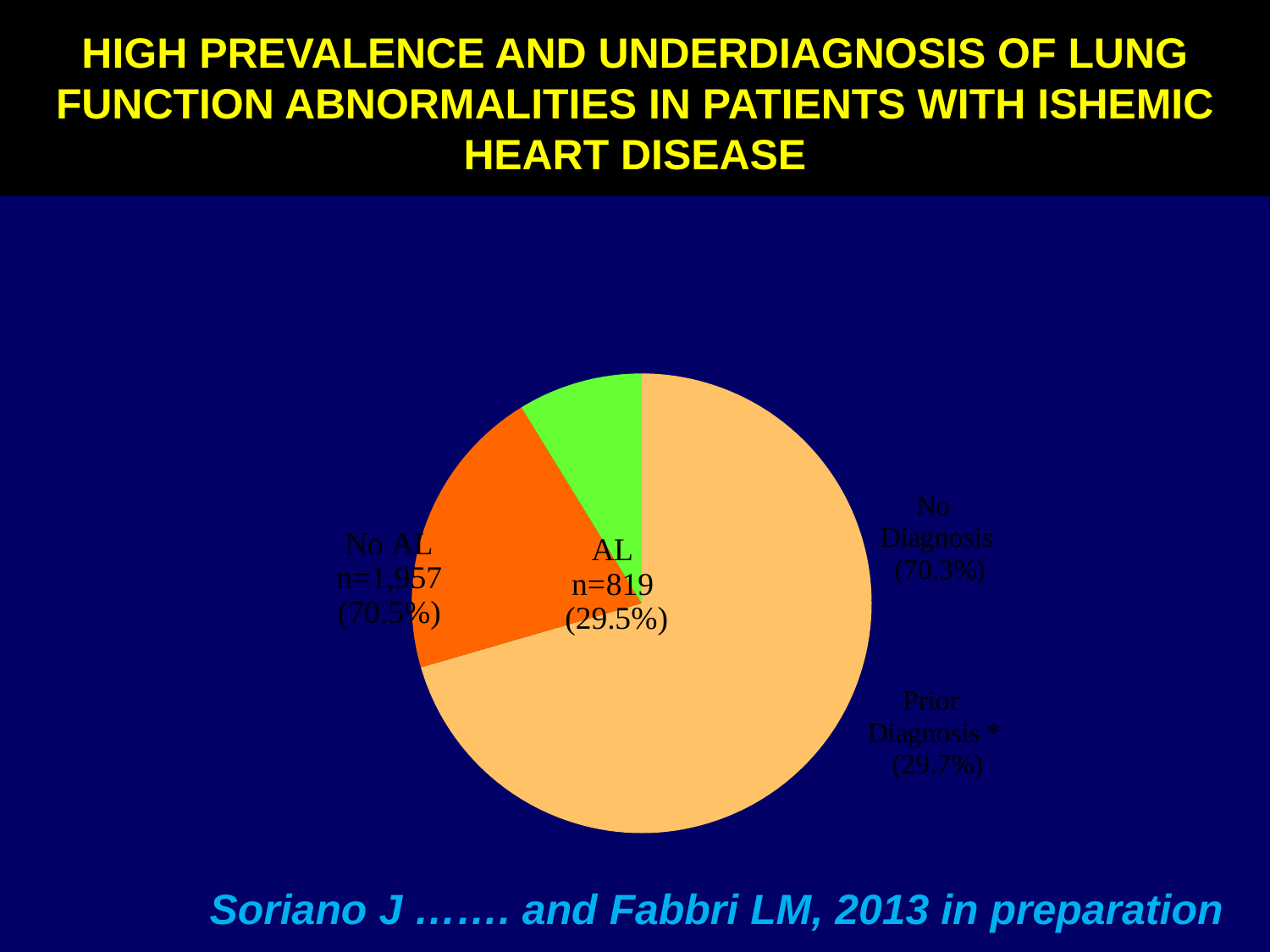
What is the combined number of patients in the No AL and AL groups? 2,776 What kind of chart is shown on the slide? pie chart What percentage is shown for Prior Diagnosis *? 29.7% What percentage is shown for No Diagnosis? 70.3% How many slices does the pie chart have? 3 What is the number of patients (n) in the No AL group? n=1,957 What is the number of patients (n) in the AL group? n=819 What is the source citation shown at the bottom of the slide? Soriano J ……. and Fabbri LM, 2013 in preparation What is the difference in patient numbers between the No AL group (n=1,957) and the AL group (n=819)? 1,138 Which group is larger, No AL or AL? No AL What percentage is shown for the No AL group? 70.5% What percentage is shown for the AL group? 29.5%